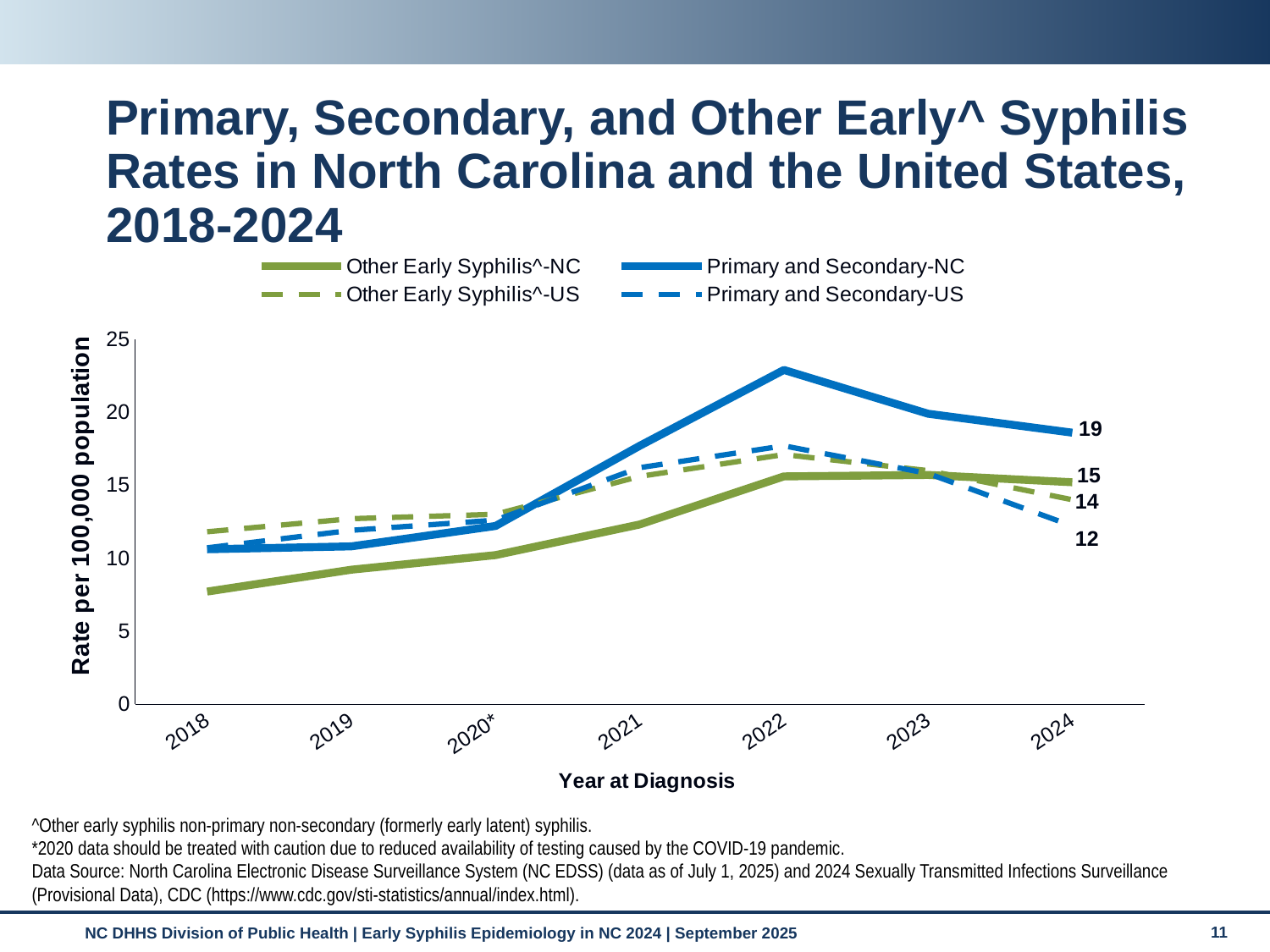
What is the 2024 value for Other Early Syphilis^-US? 14 Which series has the lowest value in 2024? Primary and Secondary-US What is the difference between the 2024 values for Primary and Secondary-NC and Primary and Secondary-US? 7 Is the value for Primary and Secondary-NC in 2022 greater or less than 20? greater Which series has the highest value in 2024? Primary and Secondary-NC Is the value for Other Early Syphilis^-NC in 2018 greater or less than 10? less What is the 2024 value for Primary and Secondary-NC? 19 In 2024, which is larger: Other Early Syphilis^-NC or Other Early Syphilis^-US? Other Early Syphilis^-NC How many years are shown on the x axis? 7 What is the 2024 value for Other Early Syphilis^-NC? 15 What is the 2024 value for Primary and Secondary-US? 12 How many series does the legend list? 4